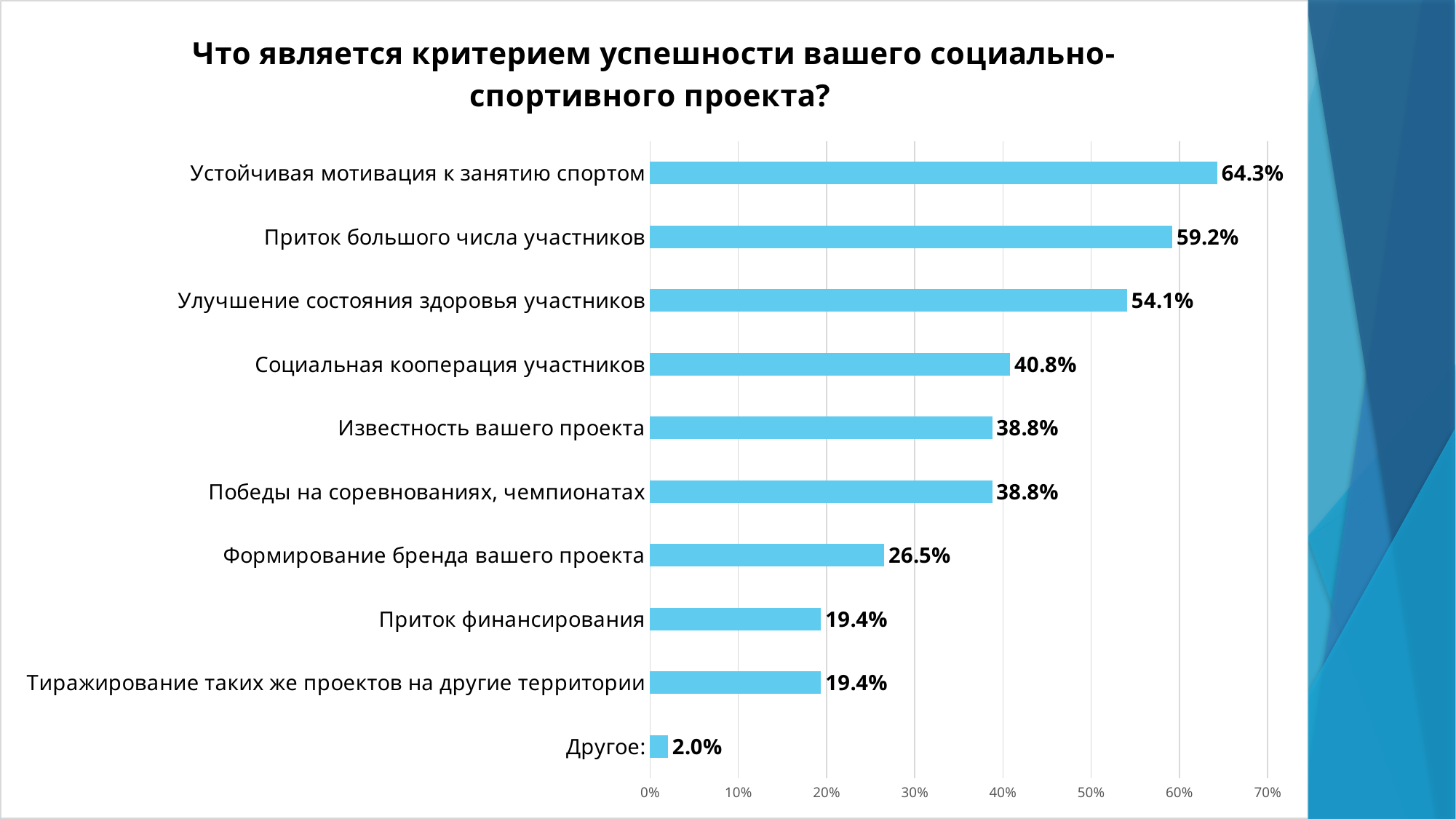
What is the value for "Устойчивая мотивация к занятию спортом"? 64.3% Which category has the lowest value? Другое: What is the difference between "Приток большого числа участников" and "Улучшение состояния здоровья участников"? 5.1% Which category has the highest value? Устойчивая мотивация к занятию спортом What kind of chart is shown on the slide? bar chart What is the difference between "Устойчивая мотивация к занятию спортом" and "Другое:"? 62.3% How many categories are shown in the chart? 10 What is the value for "Социальная кооперация участников"? 40.8% Is the value for "Улучшение состояния здоровья участников" greater or less than 50%? greater What is the value for "Приток финансирования"? 19.4% What is the title of the chart? Что является критерием успешности вашего социально-спортивного проекта? Which is larger: "Формирование бренда вашего проекта" or "Известность вашего проекта"? Известность вашего проекта